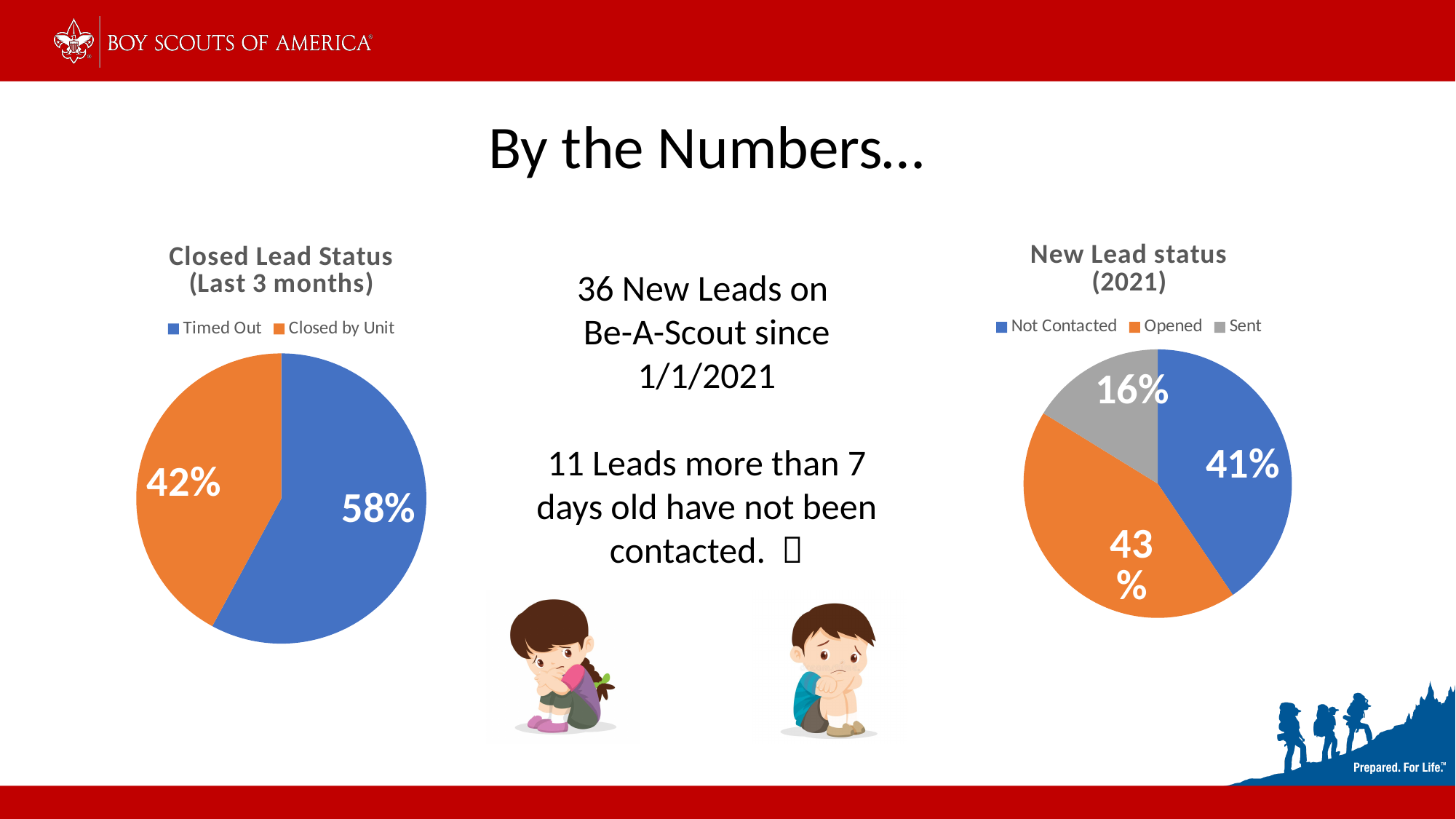
In the 'New Lead status (2021)' chart, what colour is the Sent slice? Grey In the 'Closed Lead Status (Last 3 months)' chart, which category has the larger share? Timed Out In the 'New Lead status (2021)' chart, what share of the pie is Opened? 43% In the 'New Lead status (2021)' chart, which category has the smallest share? Sent In the 'New Lead status (2021)' chart, what share of the pie is Not Contacted? 41% What kind of chart is the 'Closed Lead Status (Last 3 months)' chart? Pie chart In the 'New Lead status (2021)' chart, what share of the pie is Sent? 16% In the 'New Lead status (2021)' chart, how many categories does the legend list? 3 In the 'Closed Lead Status (Last 3 months)' chart, what is the difference in percentage points between Timed Out and Closed by Unit? 16 How many categories does the legend of the 'Closed Lead Status (Last 3 months)' chart list? 2